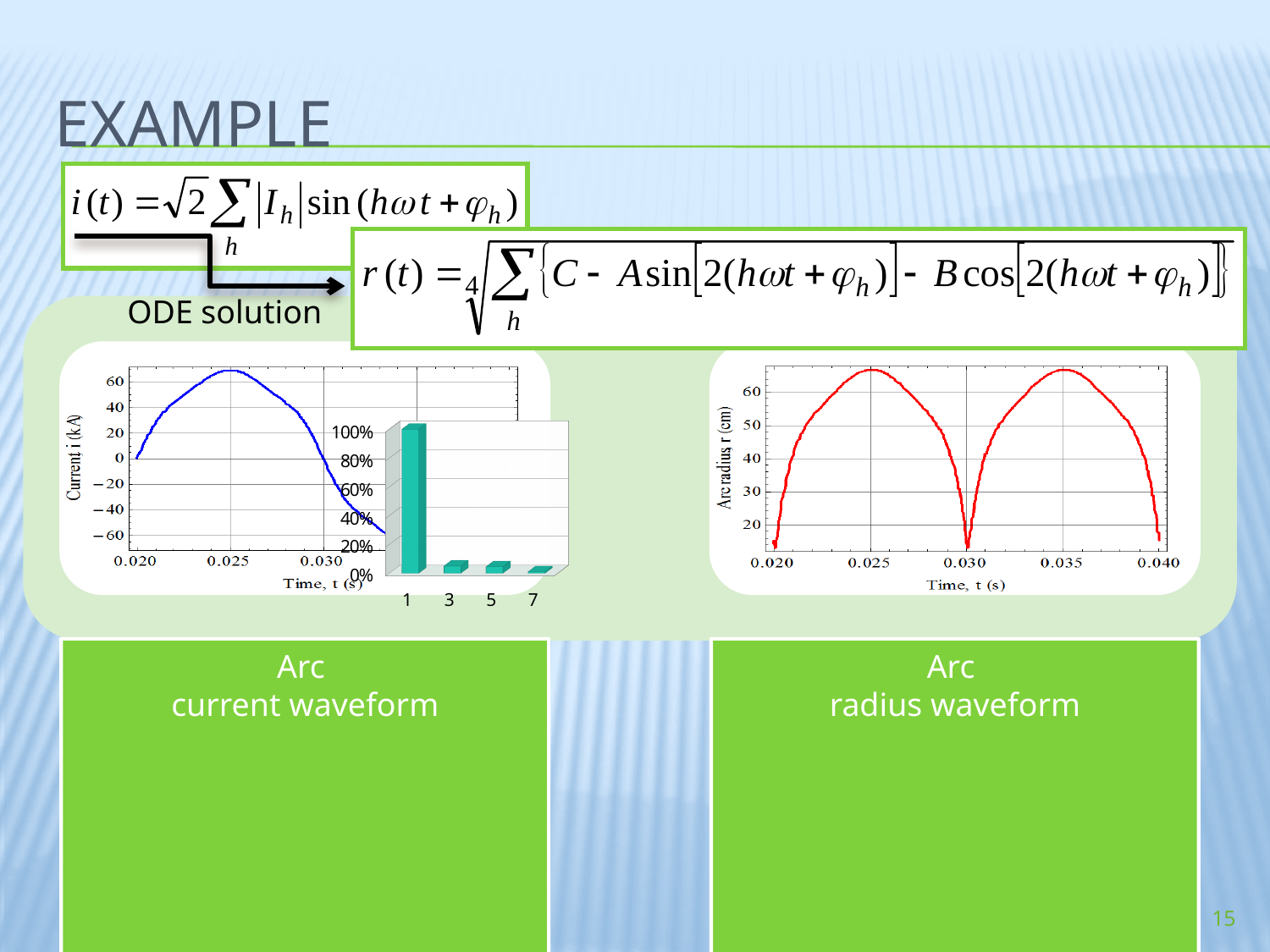
What is the y-axis label of the arc radius waveform chart? Arc radius r (cm) In the arc current waveform chart, does the current rise or fall between 0.020 s and 0.025 s? rise In the arc current waveform chart, is the current at 0.025 s greater or less than 60 kA? greater In the small bar chart inside the arc current waveform panel, how many categories are shown on the x axis? 4 In the small bar chart inside the arc current waveform panel, is the value for category 1 greater or less than 80%? greater In the small bar chart inside the arc current waveform panel, is the value for category 3 greater or less than 20%? less In the arc radius waveform chart, does the arc radius rise or fall between 0.025 s and 0.030 s? fall What kind of chart is the arc current waveform chart? line chart In the small bar chart inside the arc current waveform panel, which category has the highest value? 1 What kind of chart is the small chart with categories 1, 3, 5 and 7? bar chart